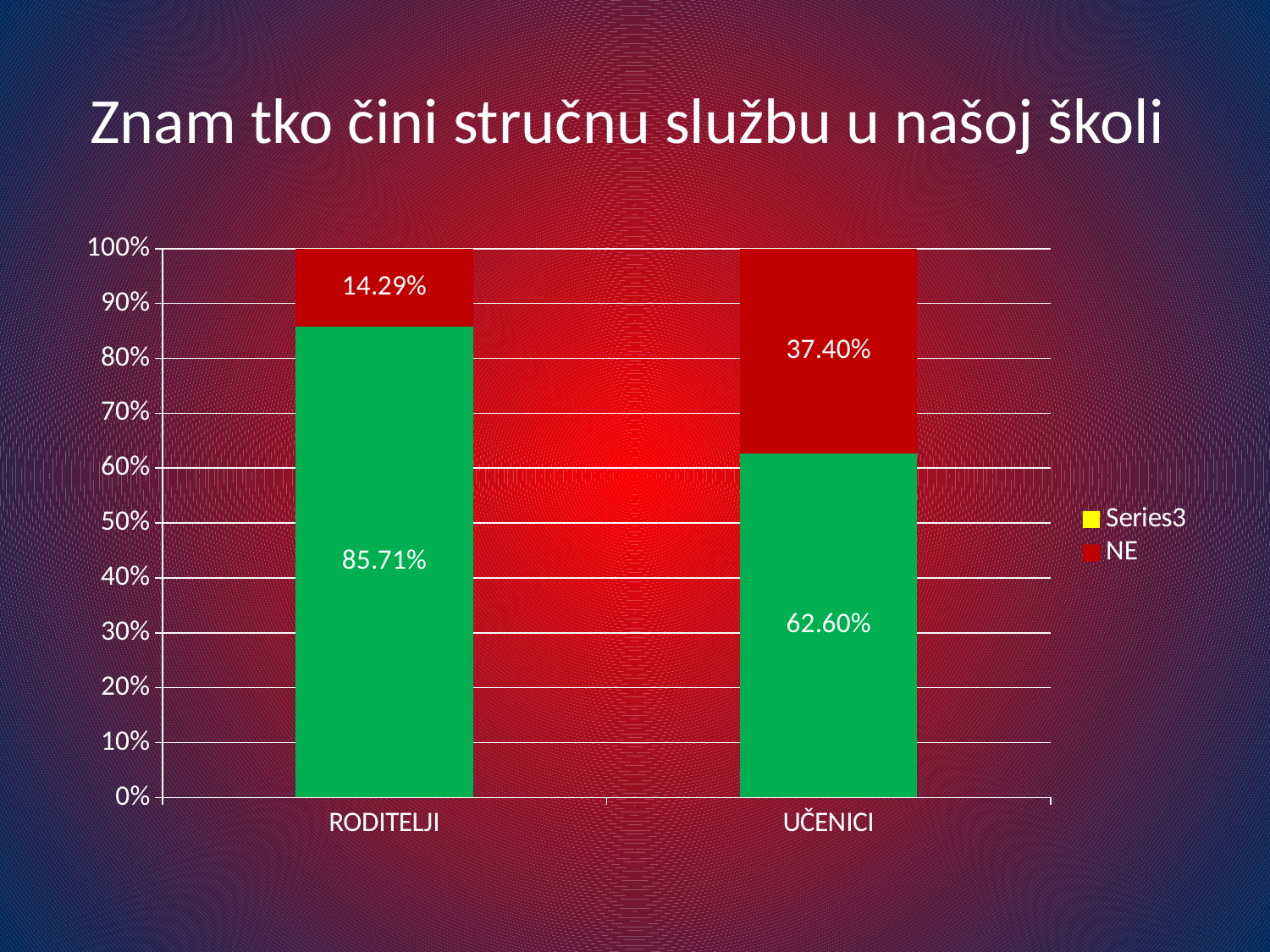
What is the value of the red (NE) segment for UČENICI? 37.40% How many series does the legend list? 2 Which category has the higher NE value, RODITELJI or UČENICI? UČENICI What is the title of the chart on the slide? Znam tko čini stručnu službu u našoj školi What is the difference between the green segment values for RODITELJI and UČENICI? 23.11% How many categories are shown on the x axis of the chart? 2 What is the total of the stacked bar for UČENICI? 100% What is the value of the green segment for RODITELJI? 85.71% What is the value of the red (NE) segment for RODITELJI? 14.29% What type of chart is shown on the slide? stacked bar chart What is the value of the green segment for UČENICI? 62.60% Which category has the largest green segment? RODITELJI